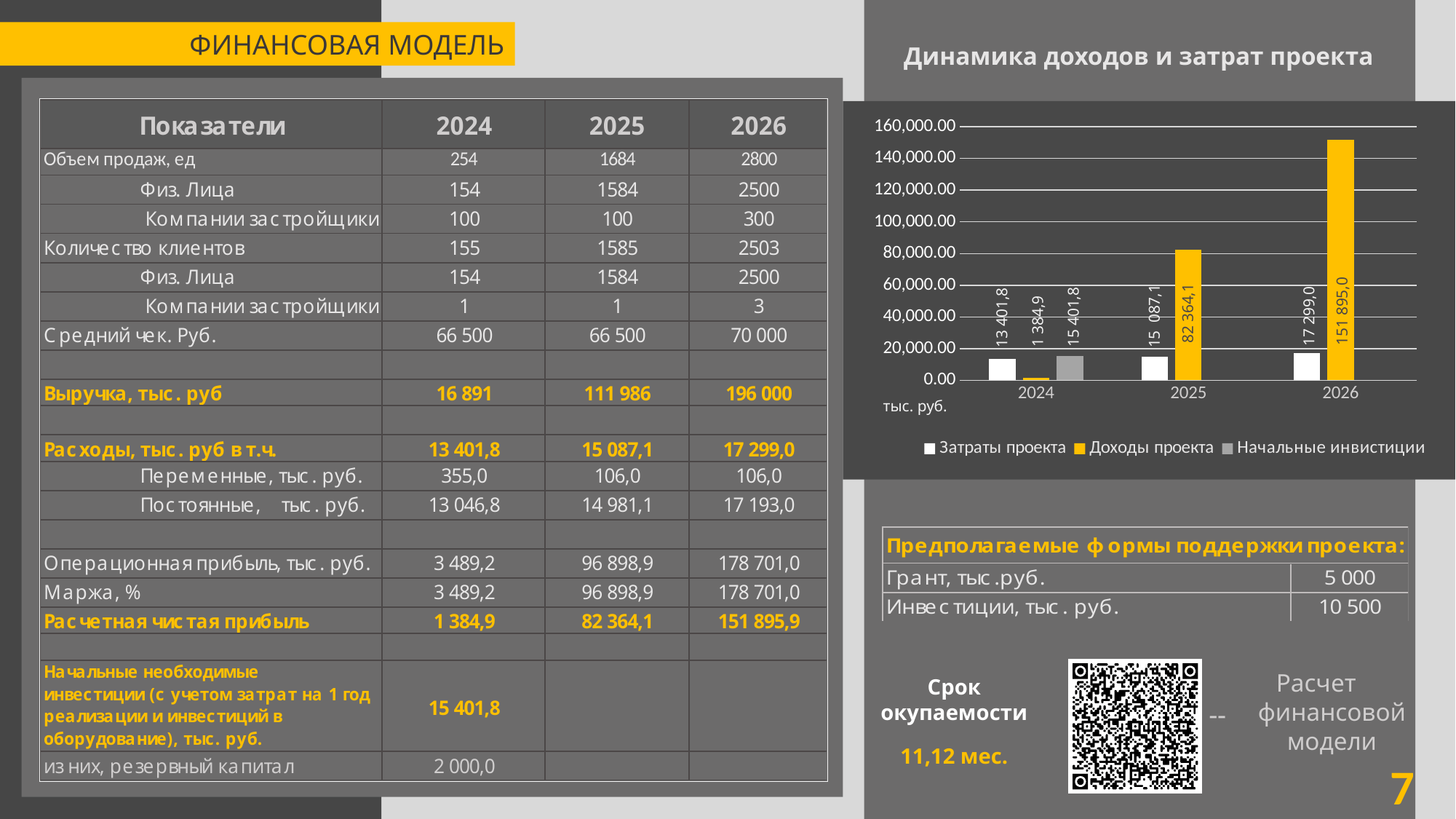
Which is larger in 2025: "Затраты проекта" or "Доходы проекта"? Доходы проекта What is the value of "Затраты проекта" for 2024 in the chart? 13 401,8 What is the value of "Начальные инвистиции" for 2024 in the chart? 15 401,8 In which year is "Доходы проекта" lowest in the chart? 2024 Does "Доходы проекта" rise or fall from 2024 to 2026 in the chart? rise Is the value of "Доходы проекта" for 2026 greater or less than 140,000.00? greater How many year categories are shown on the x axis of the chart? 3 In which year is "Доходы проекта" highest in the chart? 2026 What is the value of "Доходы проекта" for 2026 in the chart? 151 895,0 How many series does the legend of the chart list? 3 What kind of chart is shown under the title "Динамика доходов и затрат проекта"? bar chart What is the value of "Доходы проекта" for 2025 in the chart? 82 364,1